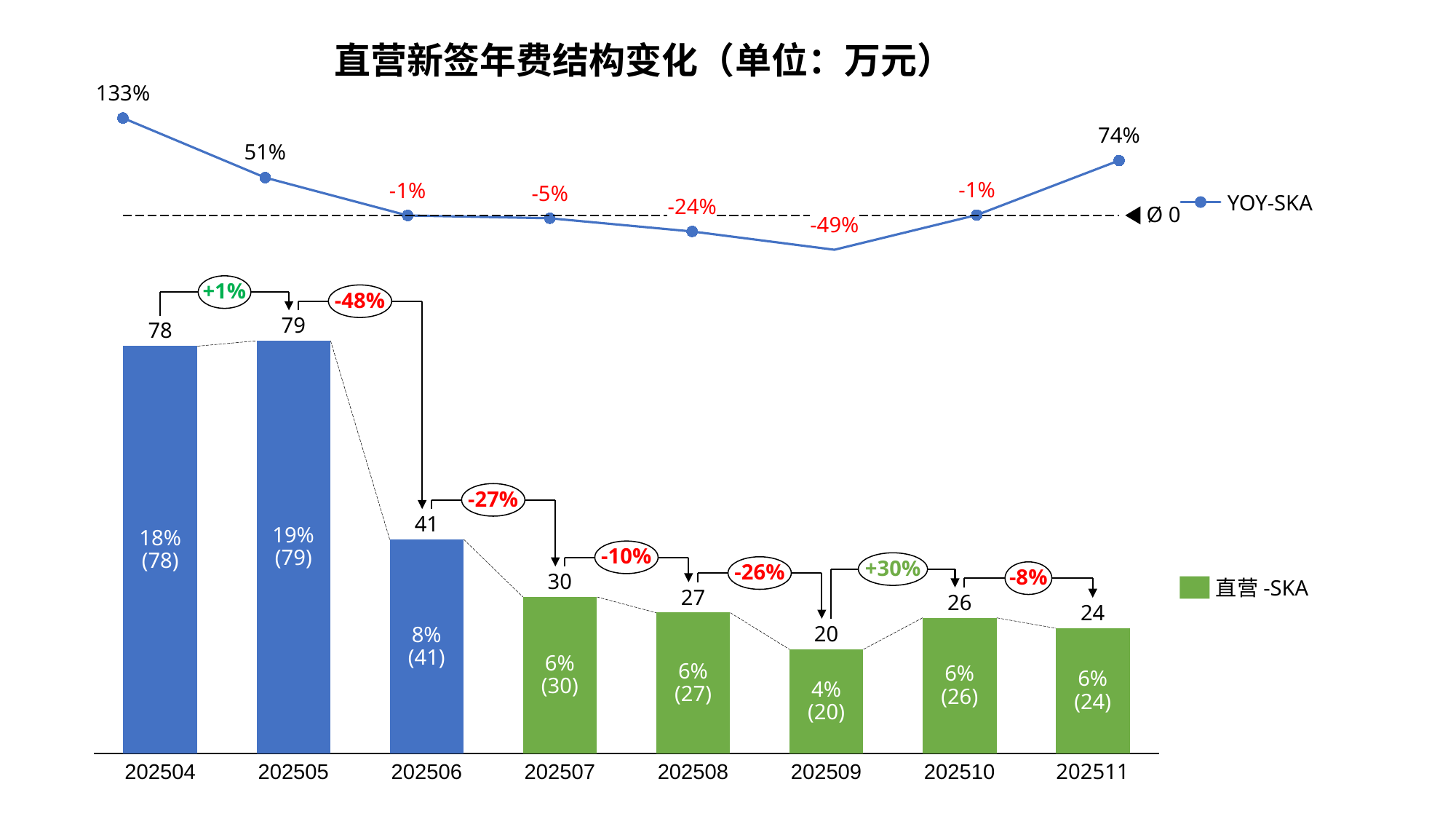
What kind of chart is shown on the slide? Combined bar and line chart What is the YOY-SKA value for 202511? 74% How many months are shown on the x axis? 8 What is the difference between the 直营-SKA values for 202505 and 202506? 38 Does the 直营-SKA bar value rise or fall from 202505 to 202509? Fall What is the title of the chart? 直营新签年费结构变化（单位：万元） Which is larger, the 直营-SKA value for 202510 or for 202511? 202510 What is the YOY-SKA value for 202509? -49% Which month has the highest 直营-SKA bar? 202505 What is the value of the 直营-SKA bar for 202504? 78 How many series does the legend list? 2 Which month has the lowest 直营-SKA bar? 202509